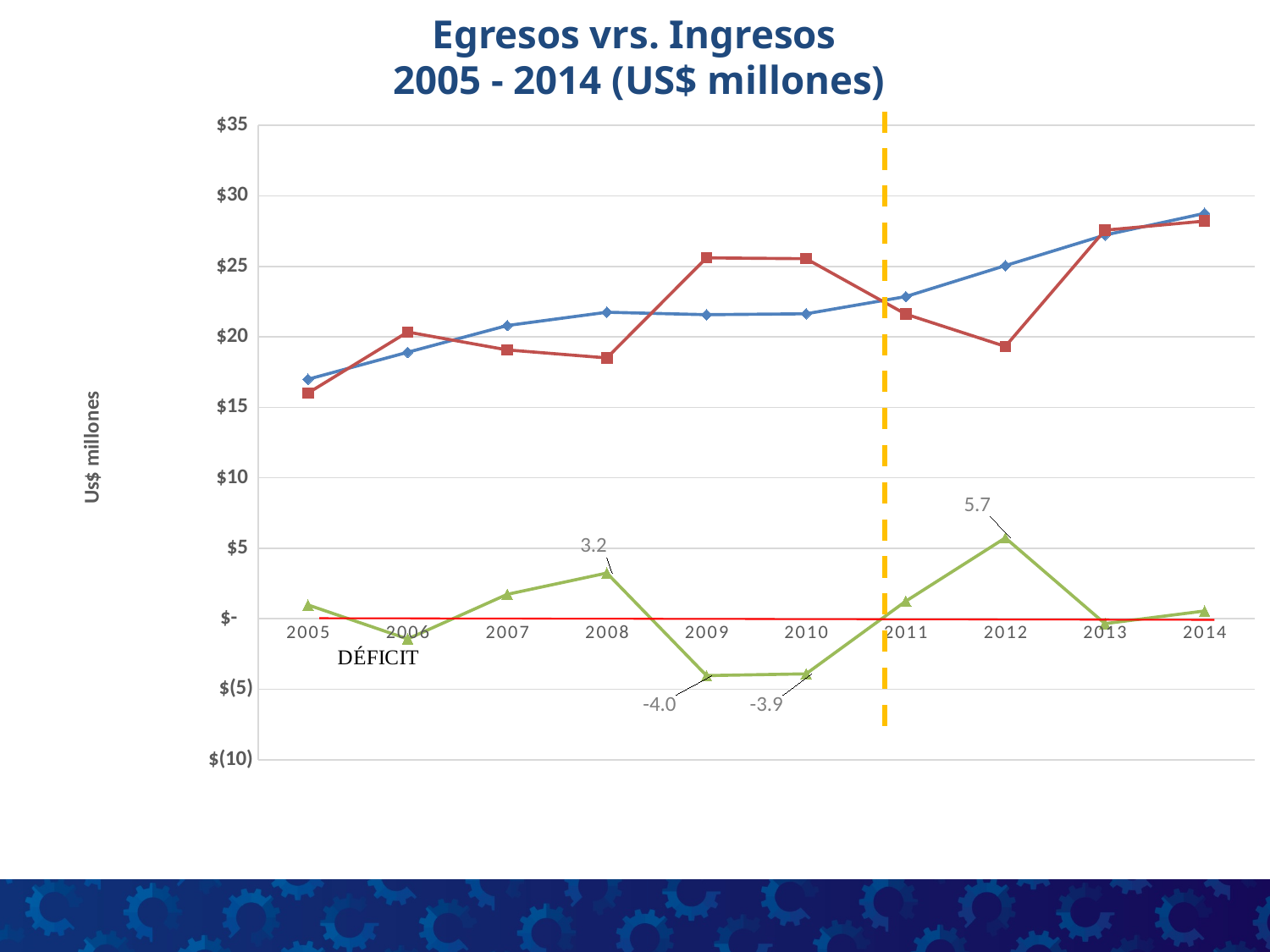
What kind of chart is shown on the slide? line chart What is the labelled value of the green triangle series in 2009? -4.0 Is the value of the blue diamond series in 2014 greater or less than $25? greater What is the labelled value of the green triangle series in 2010? -3.9 What is the title of the chart? Egresos vrs. Ingresos 2005 - 2014 (US$ millones) In 2009, which series is higher, the red square series or the blue diamond series? red square series What is the labelled value of the green triangle series in 2012? 5.7 In which year does the green triangle series reach its lowest value? 2009 What is the labelled value of the green triangle series in 2008? 3.2 How many years are plotted along the x axis? 10 What is the difference between the green series' labelled values in 2012 and 2008? 2.5 In which year does the green triangle series reach its highest value? 2012